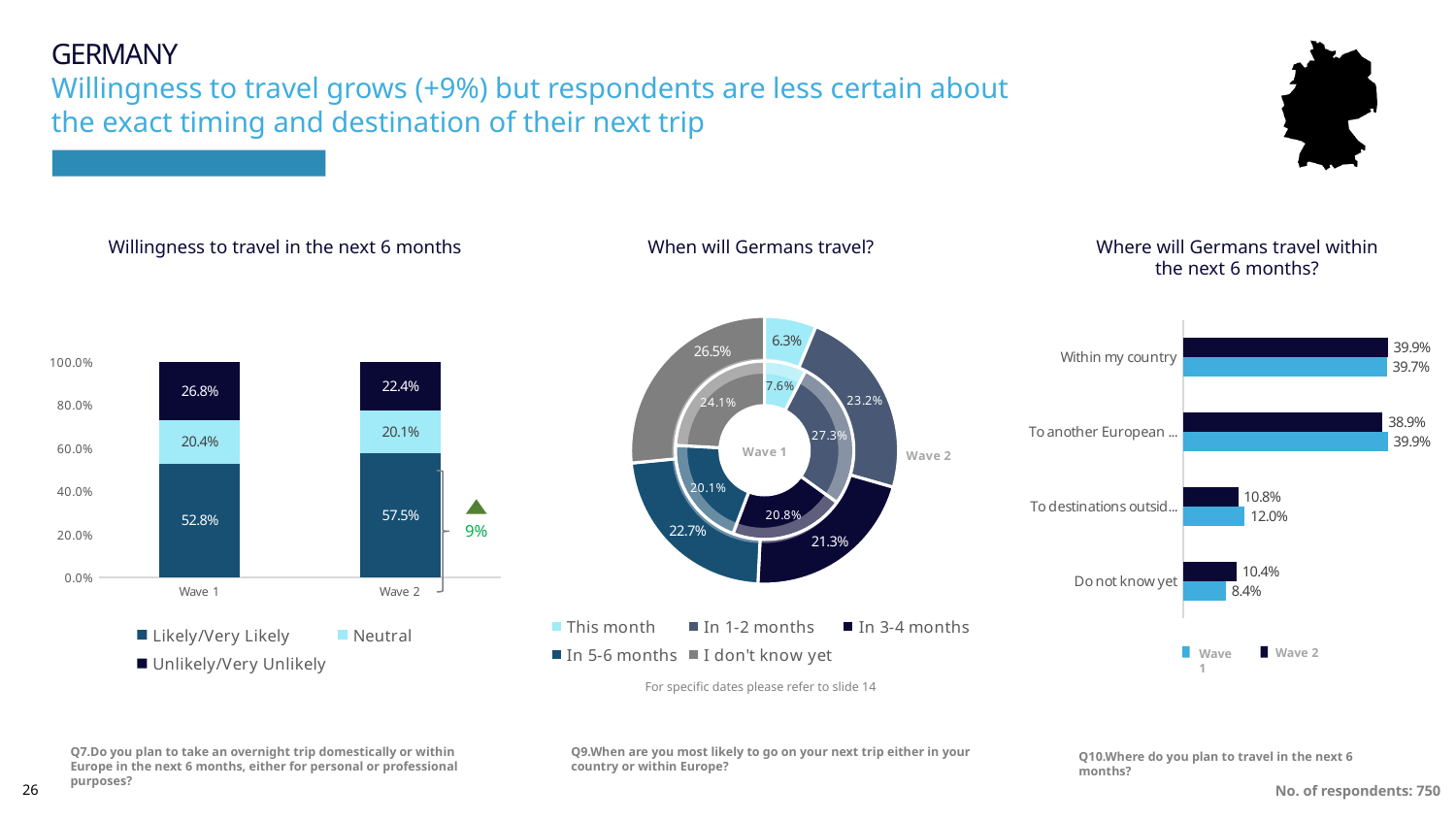
In the 'When will Germans travel?' chart, what is the Wave 2 share for 'I don't know yet'? 26.5% In the 'Willingness to travel in the next 6 months' chart, what is the Likely/Very Likely value for Wave 2? 57.5% In the 'Where will Germans travel within the next 6 months?' chart, which category has the lowest Wave 1 value? Do not know yet In the 'Willingness to travel in the next 6 months' chart, by how many percentage points does the Unlikely/Very Unlikely share fall from Wave 1 to Wave 2? 4.4 percentage points How many entries does the legend of the 'When will Germans travel?' chart list? 5 How many destination categories are shown in the 'Where will Germans travel within the next 6 months?' chart? 4 What kind of chart is 'When will Germans travel?'? Doughnut chart How many series does the legend of the 'Willingness to travel in the next 6 months' chart list? 3 In the 'When will Germans travel?' chart, what is the Wave 1 share for 'This month'? 7.6% In the 'Willingness to travel in the next 6 months' chart, what is the Neutral value for Wave 1? 20.4% In the 'Where will Germans travel within the next 6 months?' chart, what is the Wave 1 value for 'Do not know yet'? 8.4% What kind of chart is 'Willingness to travel in the next 6 months'? Stacked bar chart